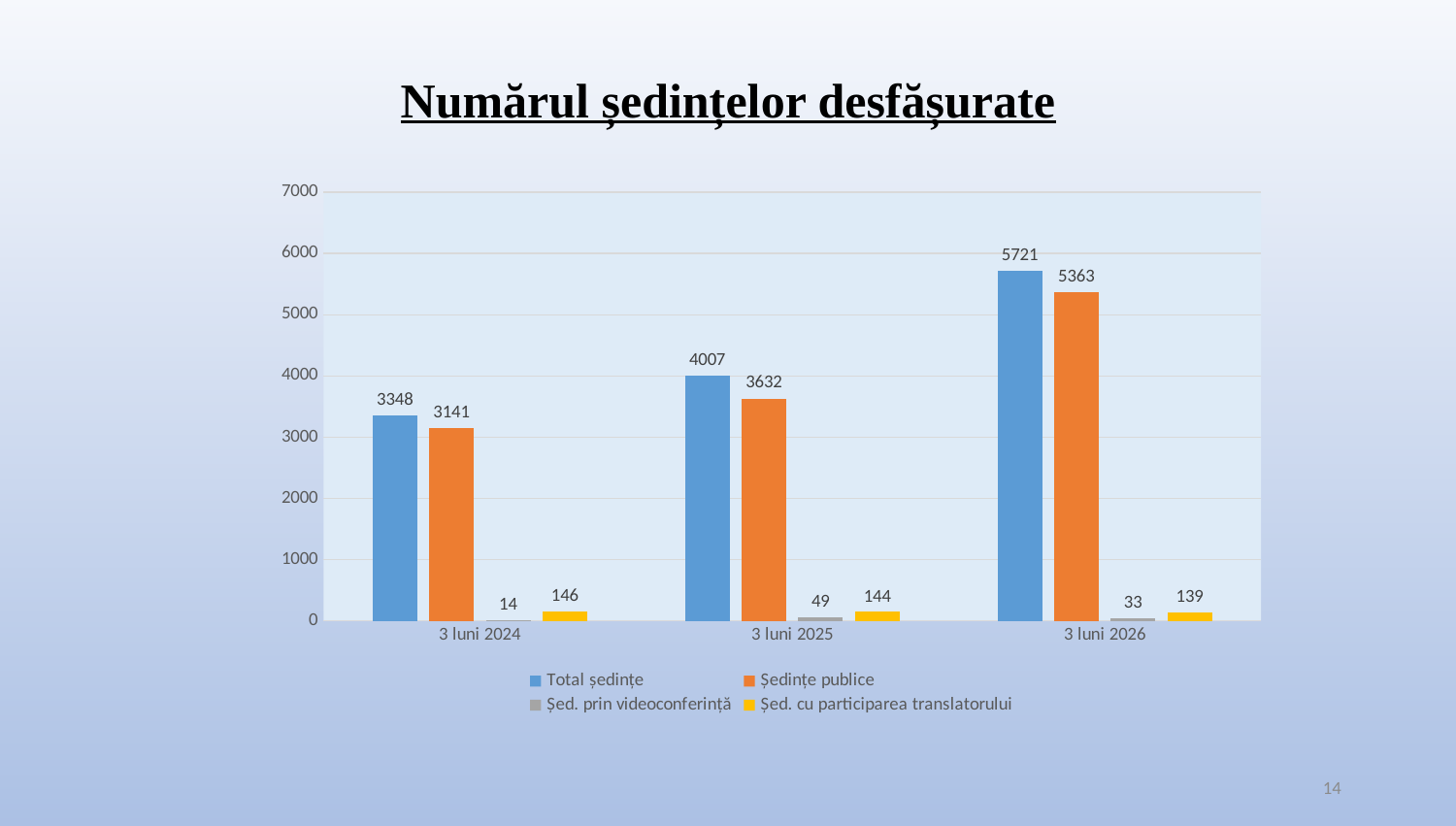
Which is larger: Șed. cu participarea translatorului for 3 luni 2024 or for 3 luni 2025? 3 luni 2024 Which period has the highest value for Total ședințe? 3 luni 2026 How many series does the legend list? 4 What is the value of Total ședințe for 3 luni 2026? 5721 Does the value of Total ședințe rise or fall from 3 luni 2024 to 3 luni 2026? Rise What is the value of Șed. prin videoconferință for 3 luni 2025? 49 What is the value of Ședințe publice for 3 luni 2024? 3141 What is the difference between Total ședințe and Ședințe publice for 3 luni 2025? 375 What is the value of Șed. cu participarea translatorului for 3 luni 2026? 139 Which period has the lowest value for Șed. prin videoconferință? 3 luni 2024 How many periods are shown on the x axis? 3 What kind of chart is shown on the slide? Bar chart